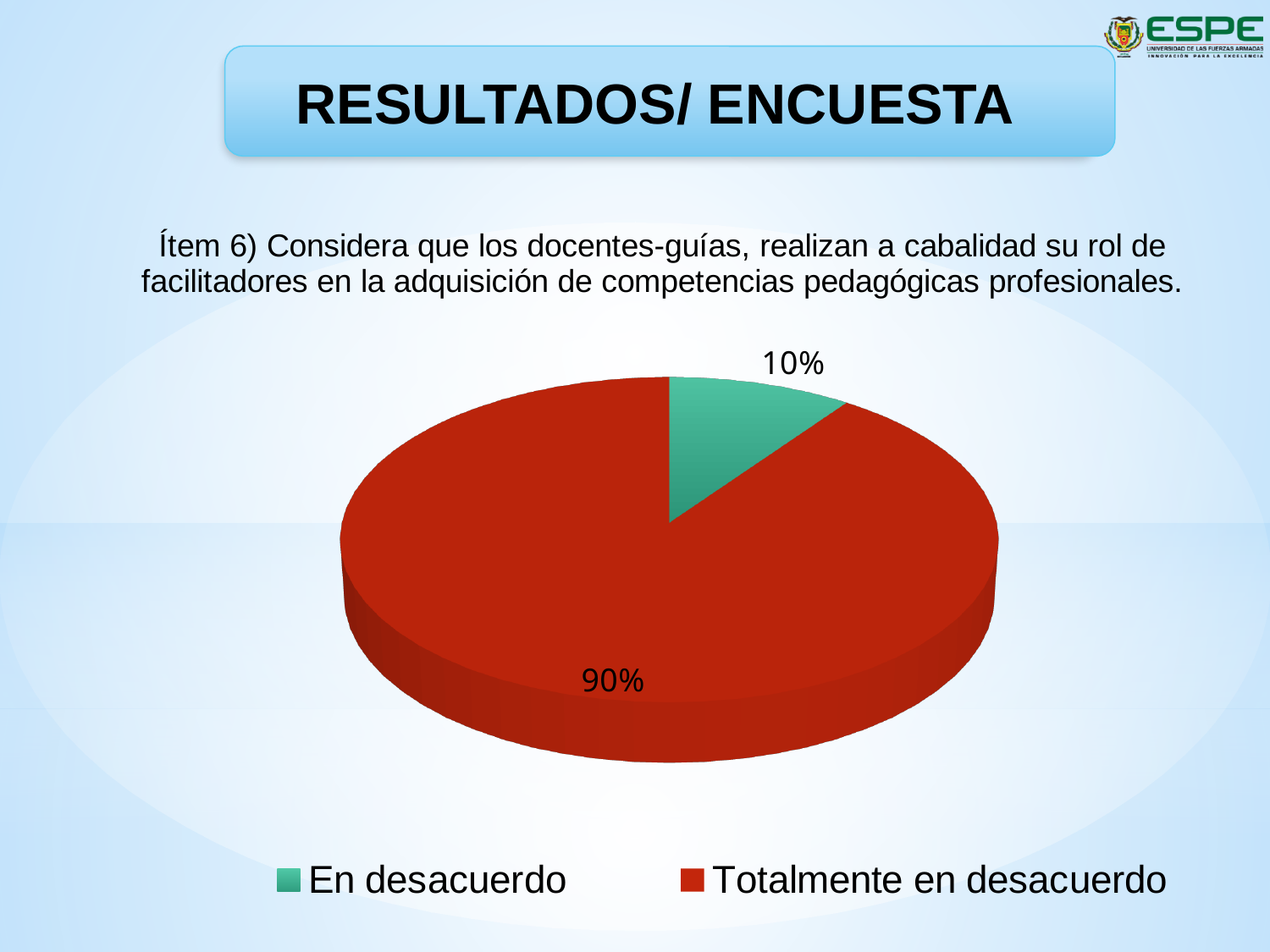
How many categories does the pie chart show? 2 What colour is the slice for "En desacuerdo"? green How many entries does the legend list? 2 What colour is the slice for "Totalmente en desacuerdo"? red What share of the pie does "En desacuerdo" represent? 10% What share of the pie does "Totalmente en desacuerdo" represent? 90% Which is larger: the slice for "En desacuerdo" or the slice for "Totalmente en desacuerdo"? Totalmente en desacuerdo What is the difference in percentage points between "Totalmente en desacuerdo" and "En desacuerdo"? 80 Which category has the smallest slice of the pie? En desacuerdo What kind of chart is shown on the slide? pie chart Which category has the largest slice of the pie? Totalmente en desacuerdo